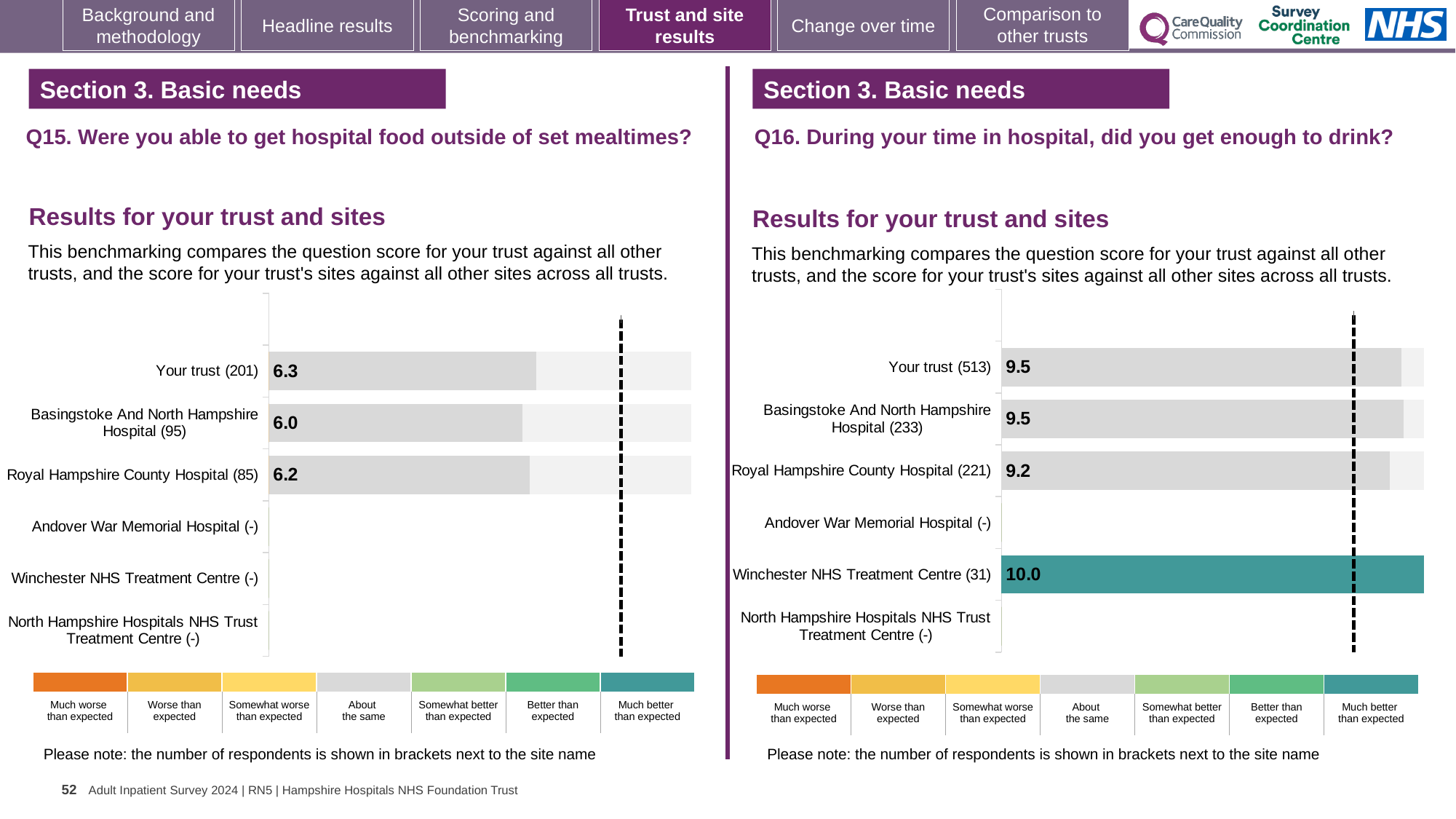
On the Q15 chart (left), what is the difference between the scores for Your trust and Royal Hampshire County Hospital? 0.1 On the Q16 chart (right), what is the difference between the scores for Your trust and Royal Hampshire County Hospital? 0.3 On the Q15 chart (left), what is the score for Your trust? 6.3 On the Q15 chart (left), what is the score for Basingstoke And North Hampshire Hospital? 6.0 On the Q16 chart (right), what is the score for Royal Hampshire County Hospital? 9.2 On the Q16 chart (right), is the score for Your trust larger than, smaller than, or equal to the score for Basingstoke And North Hampshire Hospital? equal What kind of chart is used on the Q15 chart (left)? bar chart On the Q15 chart (left), how many respondents are shown for Royal Hampshire County Hospital? 85 On the Q16 chart (right), which site has the highest score? Winchester NHS Treatment Centre On the Q16 chart (right), which benchmark category does the colour of the Winchester NHS Treatment Centre bar correspond to? Much better than expected On the Q15 chart (left), which site with a plotted score has the lowest value? Basingstoke And North Hampshire Hospital On the Q16 chart (right), what is the score for Winchester NHS Treatment Centre? 10.0